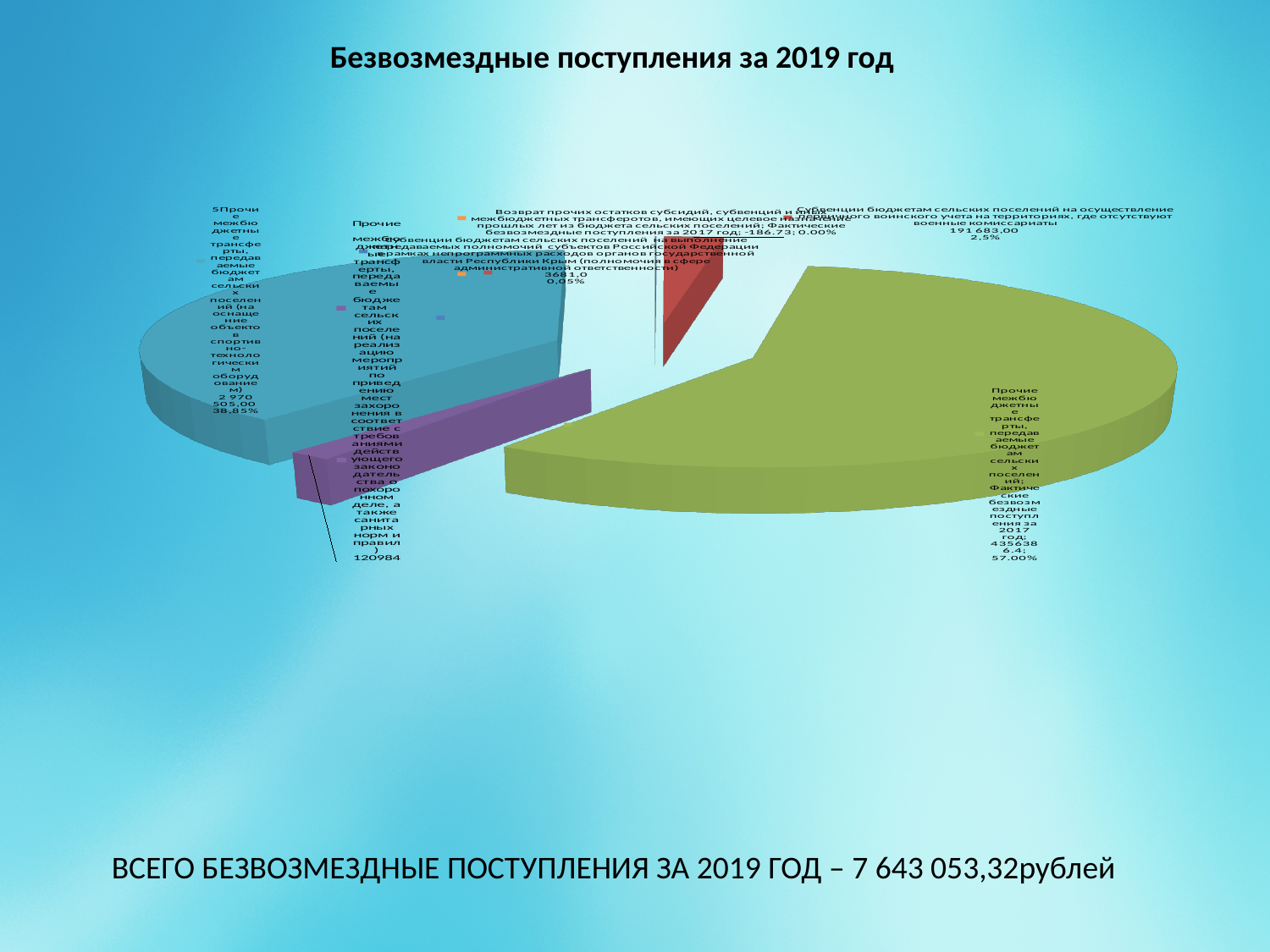
What share of the pie is labelled for 'Субвенции бюджетам сельских поселений на осуществление первичного воинского учета на территориях, где отсутствуют военные комиссариаты'? 2,5% What share of the pie is labelled for the slice 'Прочие межбюджетные трансферты, передаваемые бюджетам сельских поселений (на оснащение объектов спортивно-технологическим оборудованием)'? 38,85% What value is labelled for 'Субвенции бюджетам сельских поселений на осуществление первичного воинского учета на территориях, где отсутствуют военные комиссариаты'? 191 683,00 According to the text below the chart, what is the total of безвозмездные поступления for 2019? 7 643 053,32 рублей Which slice is larger: the one for 'Субвенции ... первичного воинского учета' (2,5%) or the one for 'на оснащение объектов спортивно-технологическим оборудованием' (38,85%)? на оснащение объектов спортивно-технологическим оборудованием What kind of chart is shown on the slide? pie chart Which slice has the largest share of the pie? Прочие межбюджетные трансферты, передаваемые бюджетам сельских поселений (57.00%) What share is labelled for 'Субвенции бюджетам сельских поселений на выполнение передаваемых полномочий субъектов Российской Федерации ... (полномочия в сфере административной ответственности)'? 0,05% What value is labelled for the slice about 'приведению мест захоронения в соответствие с требованиями действующего законодательства о похоронном деле'? 120984 What value is labelled for the slice 'Прочие межбюджетные трансферты, передаваемые бюджетам сельских поселений (на оснащение объектов спортивно-технологическим оборудованием)'? 2 970 505,00 What is the title of the chart? Безвозмездные поступления за 2019 год